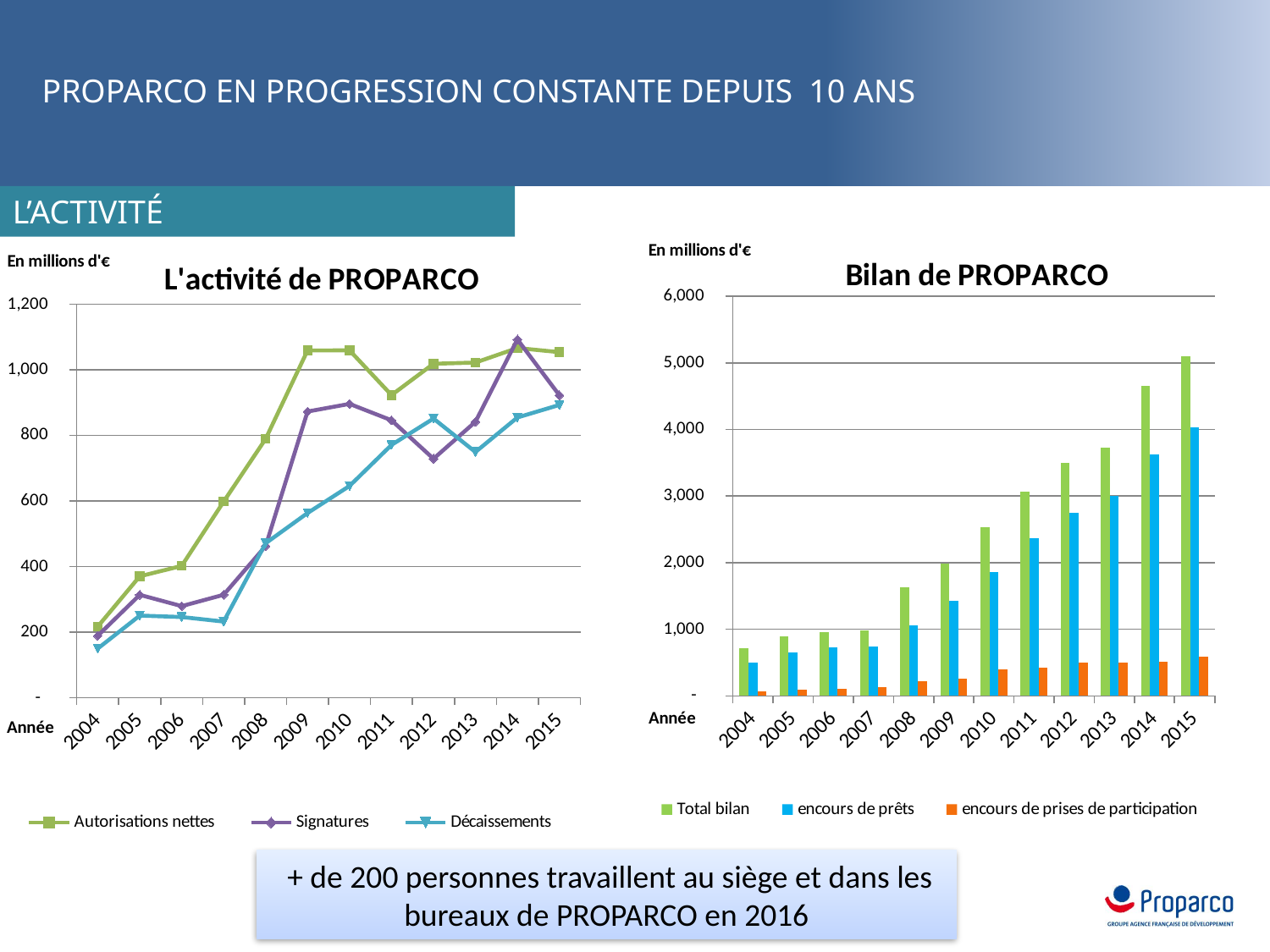
In "Bilan de PROPARCO", in which year is Total bilan at its highest? 2015 In "L'activité de PROPARCO", is the value of Décaissements for 2004 greater or less than 200? less What are the three legend entries of "Bilan de PROPARCO"? Total bilan, encours de prêts, encours de prises de participation In "L'activité de PROPARCO", do the Autorisations nettes values rise or fall from 2004 to 2009? rise In "L'activité de PROPARCO", in which year is Signatures at its highest? 2014 What kind of chart is "Bilan de PROPARCO"? bar chart In "Bilan de PROPARCO", is the value of Total bilan for 2014 greater or less than 4,000? greater In "L'activité de PROPARCO", is the value of Autorisations nettes for 2009 greater or less than 1,000? greater How many years are plotted on the x axis of "L'activité de PROPARCO"? 12 How many series does the legend of "L'activité de PROPARCO" list? 3 In "L'activité de PROPARCO", which is larger in 2012: Signatures or Décaissements? Décaissements What kind of chart is "L'activité de PROPARCO"? line chart